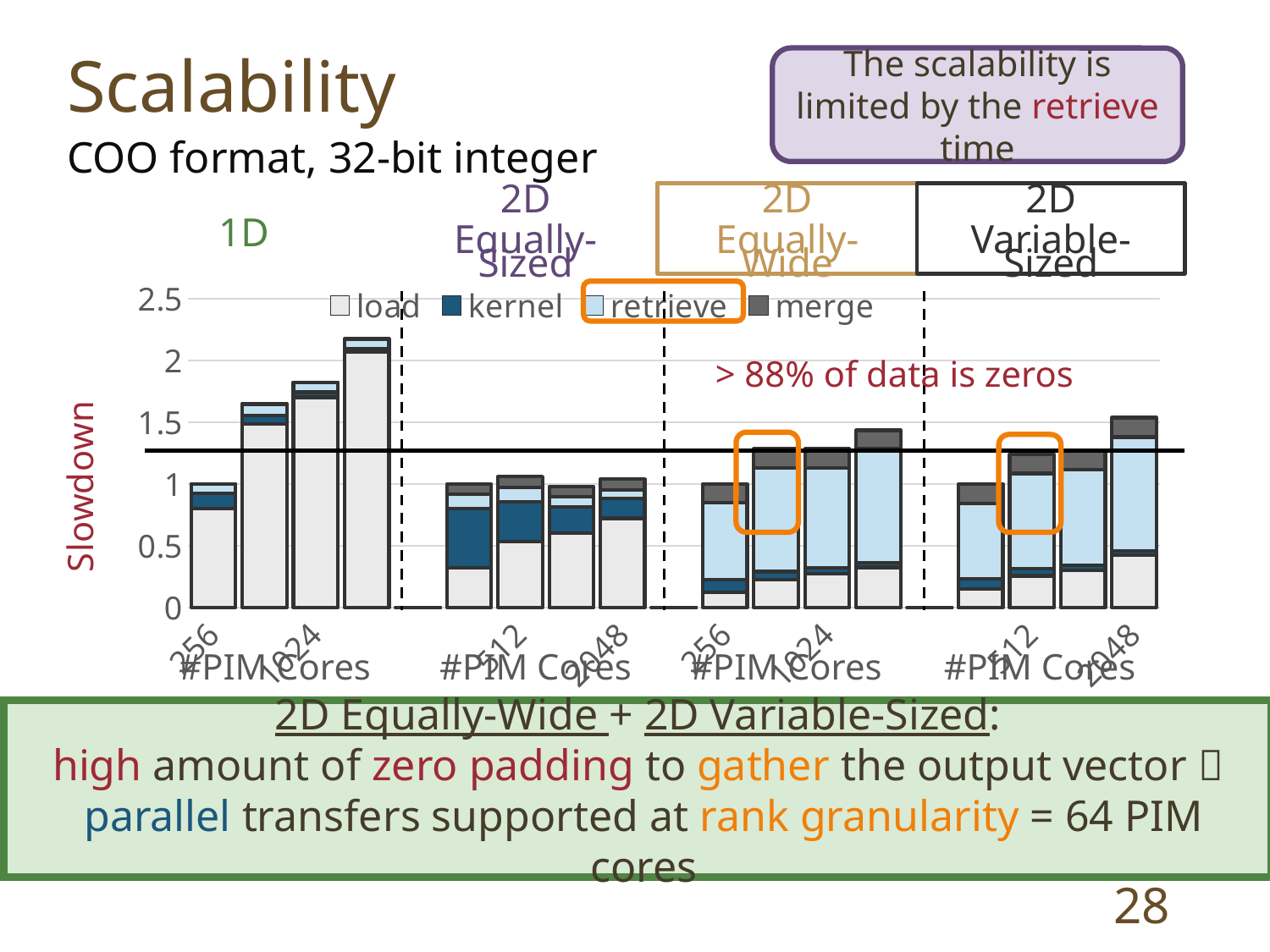
Which bar in the 1D group has the highest total slowdown? 2048 How many bars are plotted in the 1D group of the chart? 4 Is the total slowdown for 512 PIM cores in the 2D Equally-Sized group greater or less than 1.5? less What is the label of the y axis of the chart? Slowdown Which bar in the 1D group has the lowest total slowdown? 256 How many series does the chart legend list? 4 What are the four series listed in the chart legend? load, kernel, retrieve, merge In the 1D group, does the slowdown rise or fall as the number of PIM cores increases from 256 to 2048? Rises What kind of chart is shown on the slide? Stacked bar chart Which has the larger total slowdown at 1024 PIM cores: the 1D group or the 2D Equally-Wide group? 1D Is the total slowdown for 1024 PIM cores in the 2D Equally-Wide group greater or less than 1? greater Is the total slowdown for 2048 PIM cores in the 1D group greater or less than 2? greater